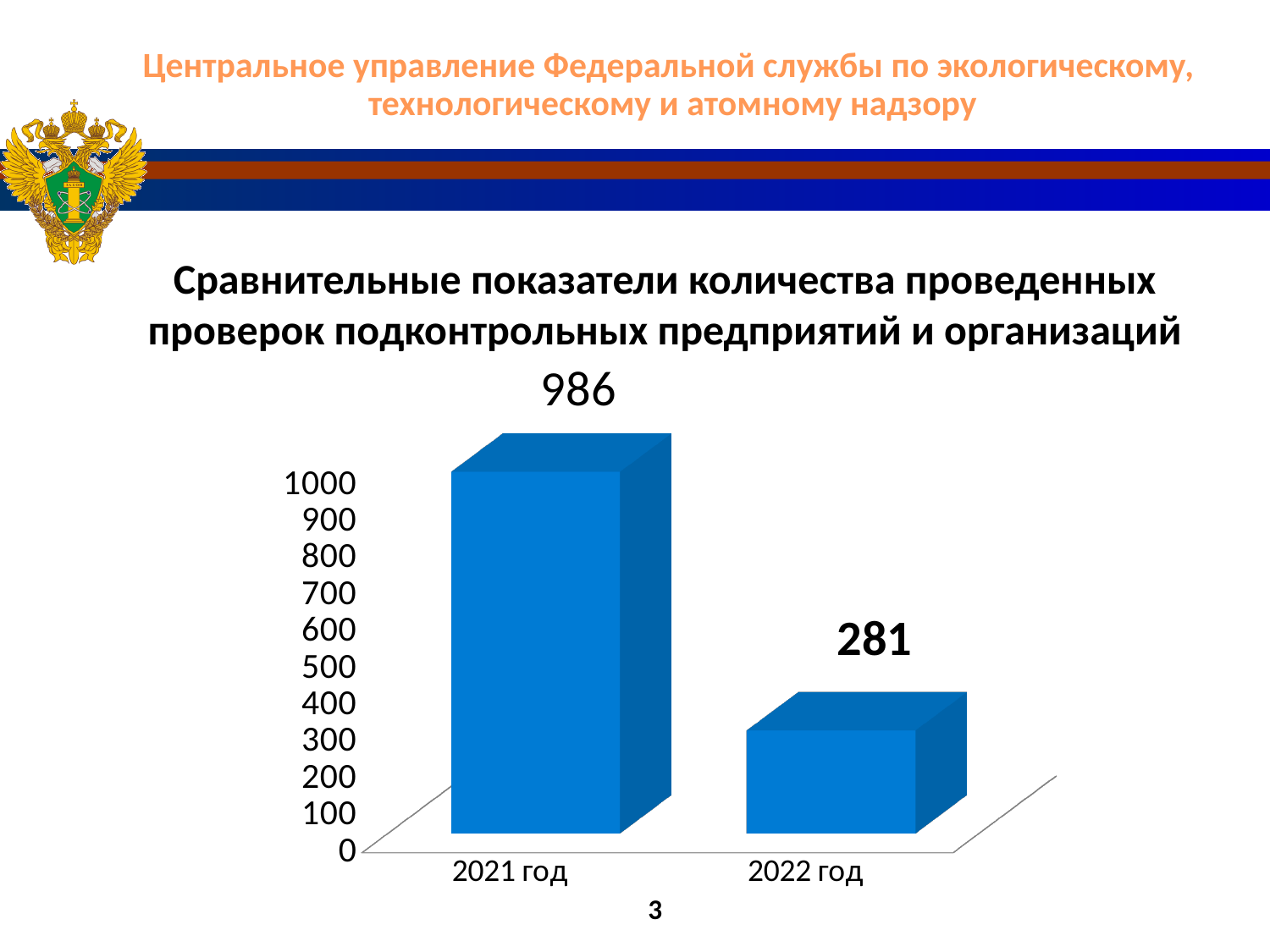
Which year has the highest value? 2021 год Is the value for 2022 год greater or less than 300? less What is the title of the chart? Сравнительные показатели количества проведенных проверок подконтрольных предприятий и организаций Which is larger, the value for 2021 год or the value for 2022 год? 2021 год Which year has the lowest value? 2022 год What is the difference between the values for 2021 год and 2022 год? 705 What is the value for 2022 год? 281 What kind of chart is shown on the slide? bar chart How many categories are shown on the x axis? 2 Do the values rise or fall from 2021 год to 2022 год? fall What is the value for 2021 год? 986 Is the value for 2021 год greater or less than 900? greater